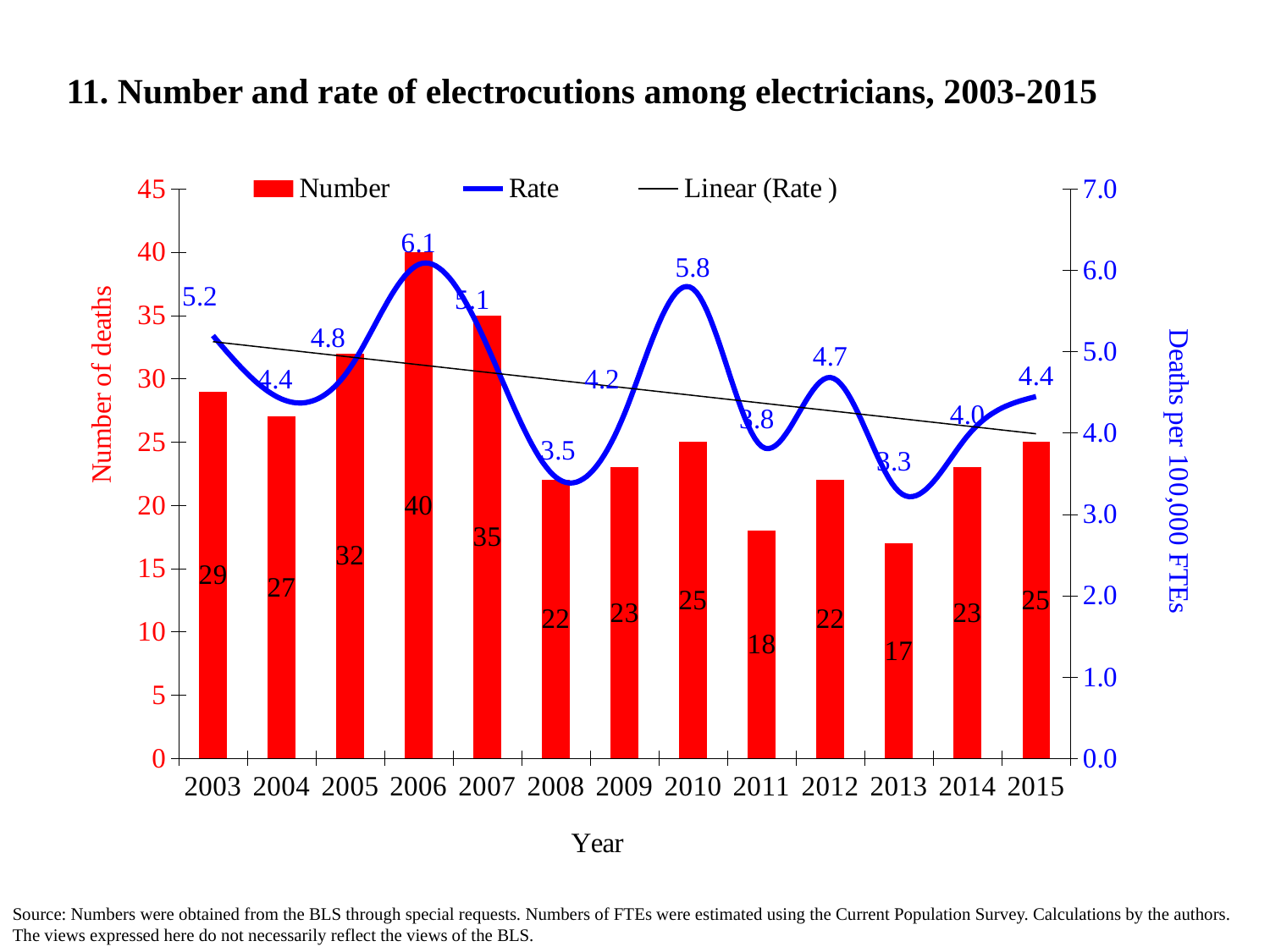
Is the rate for 2008 greater or less than 4.0? less Which year has the larger number of deaths, 2005 or 2007? 2007 What is the rate of electrocutions (deaths per 100,000 FTEs) in 2010? 5.8 Does the Linear (Rate) trend line rise or fall from 2003 to 2015? Fall What kind of chart is this? Combined bar and line chart What is the number of deaths among electricians in 2006? 40 How many years are shown on the x axis? 13 Which year has the highest number of deaths? 2006 What is the difference between the number of deaths in 2006 and in 2013? 23 Which year has the lowest rate of electrocutions? 2013 Which year has the lowest number of deaths? 2013 How many entries does the legend list? 3